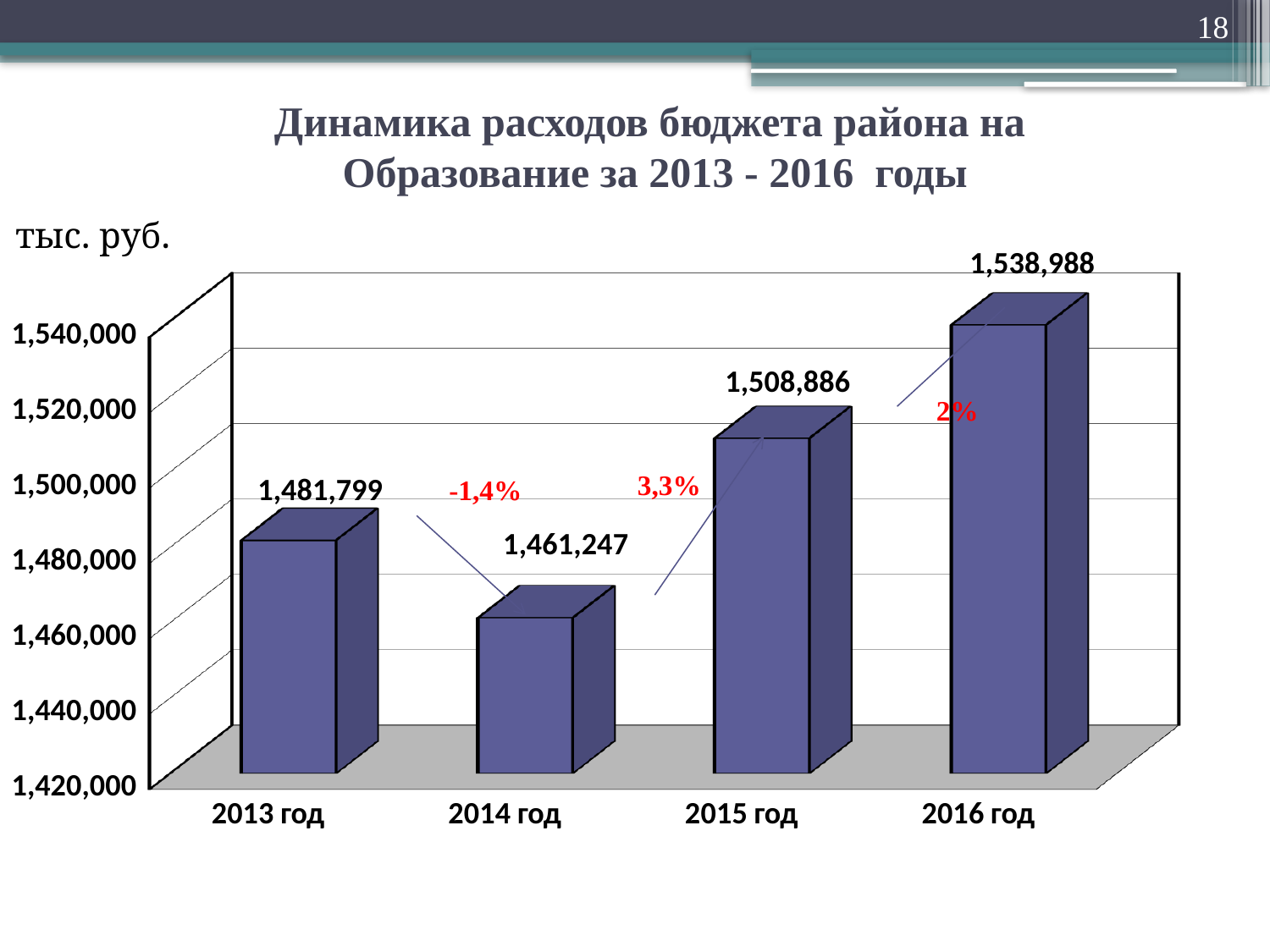
Which year has the highest value? 2016 год Which year has the lowest value? 2014 год What is the difference between the values for 2016 год and 2015 год? 30,102 What percentage change is shown between 2014 год and 2015 год? 3,3% What unit of measurement is indicated for the chart? тыс. руб. What is the difference between the values for 2013 год and 2014 год? 20,552 What is the value for 2013 год? 1,481,799 What kind of chart is shown on the slide? bar chart How many bars are shown in the chart? 4 What is the value for 2016 год? 1,538,988 Which is larger, the value for 2013 год or the value for 2015 год? 2015 год What is the value for 2014 год? 1,461,247